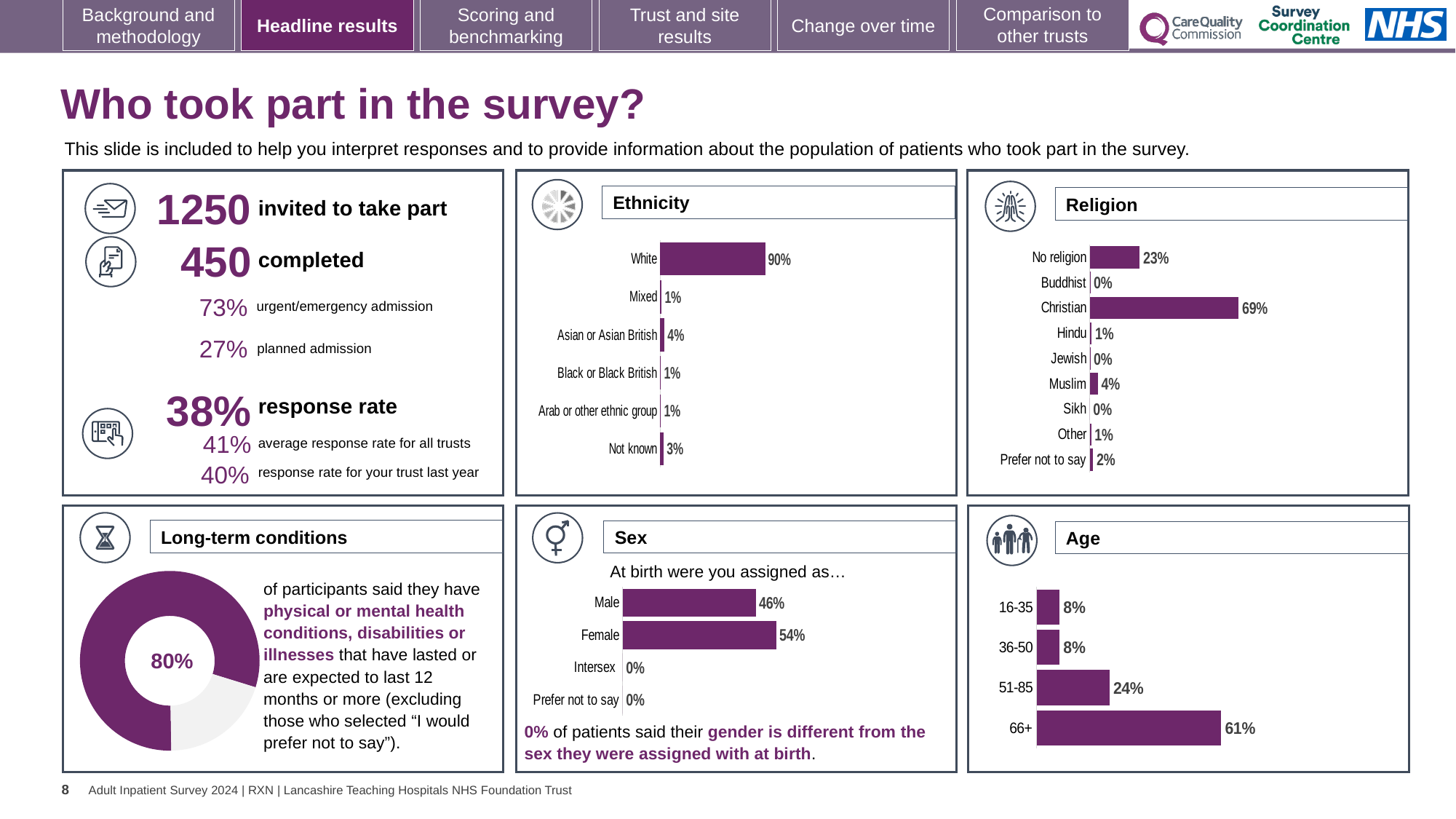
In the Long-term conditions chart, what share of participants said they have long-term conditions? 80% In the Age chart, which age group has the highest value? 66+ In the Religion chart, which category has the highest value? Christian In the Sex chart, which is larger, Male or Female? Female In the Age chart, what is the value for 51-85? 24% In the Religion chart, what is the value for No religion? 23% In the Religion chart, how many categories are shown? 9 In the Ethnicity chart, what is the value for Not known? 3% In the Ethnicity chart, what percentage of respondents were White? 90% What kind of chart is the Long-term conditions chart? Doughnut chart In the Ethnicity chart, how many categories are shown? 6 In the Sex chart, what is the difference between the Female and Male values? 8%